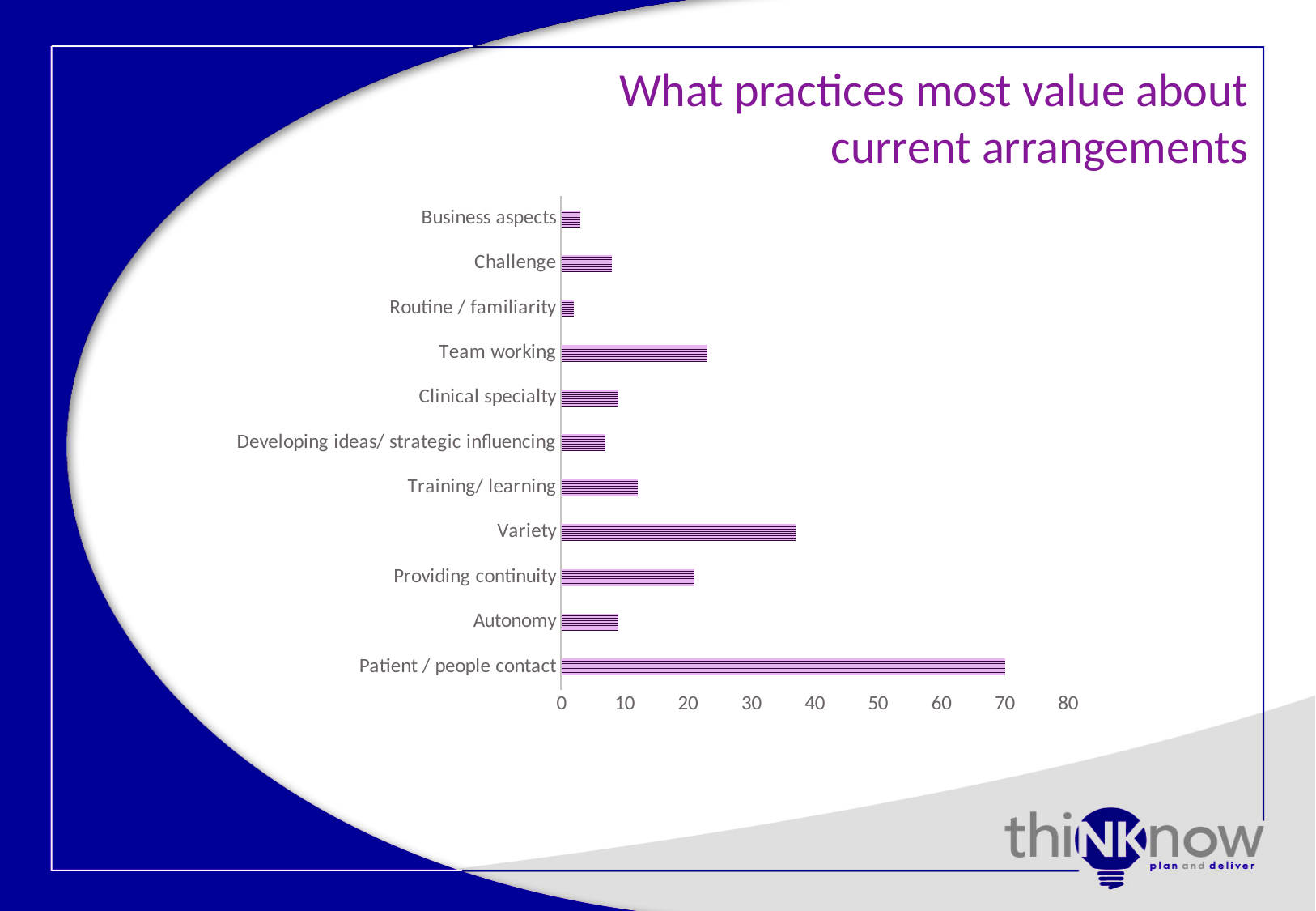
What is the highest value shown on the horizontal axis? 80 What kind of chart is shown on the slide? bar chart Which has a larger value, Challenge or Training/ learning? Training/ learning Is the value for Challenge greater or less than 10? less Which category has the highest value? Patient / people contact What is the title of the slide? What practices most value about current arrangements Which has a larger value, Variety or Team working? Variety How many categories are plotted in the chart? 11 Is the value for Patient / people contact greater or less than 60? greater Which category has the lowest value? Routine / familiarity Is the value for Variety greater or less than 30? greater